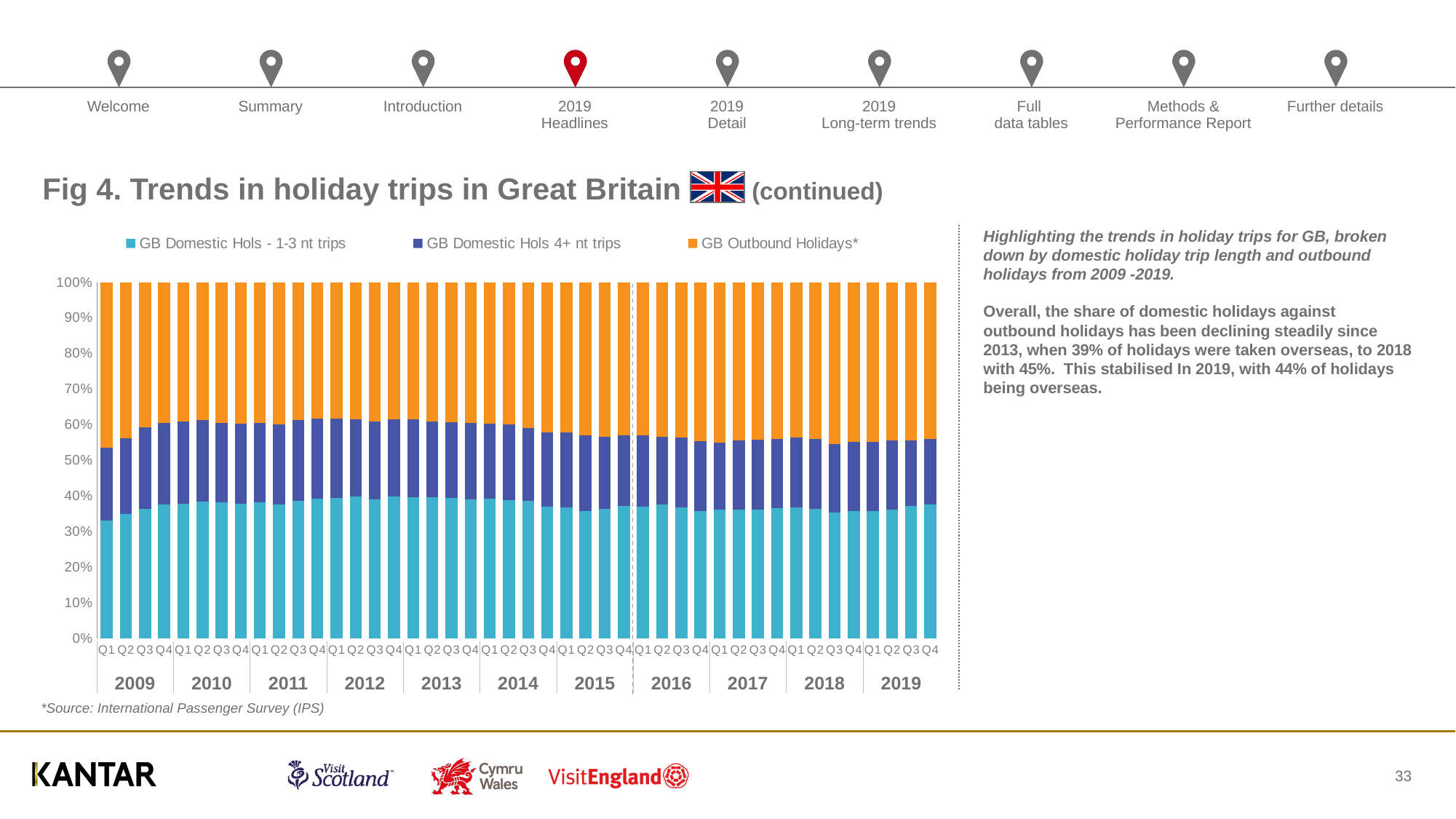
Is the combined share of domestic holidays (1-3 nt plus 4+ nt trips) in Q1 2009 greater or less than 50%? greater How many series does the chart legend list? 3 Which colour represents GB Outbound Holidays* in the chart? Orange How many quarterly bars are plotted in the chart? 44 Is the value for GB Domestic Hols - 1-3 nt trips in Q4 2012 greater or less than 30%? greater Is the share of GB Outbound Holidays in Q4 2011 greater or less than 50%? less What kind of chart is shown on the slide? Stacked bar chart How many years are shown along the x axis of the chart? 11 Does the combined share of domestic holidays rise or fall from 2013 to 2018? fall What is the title of the chart on the slide? Fig 4. Trends in holiday trips in Great Britain (continued)